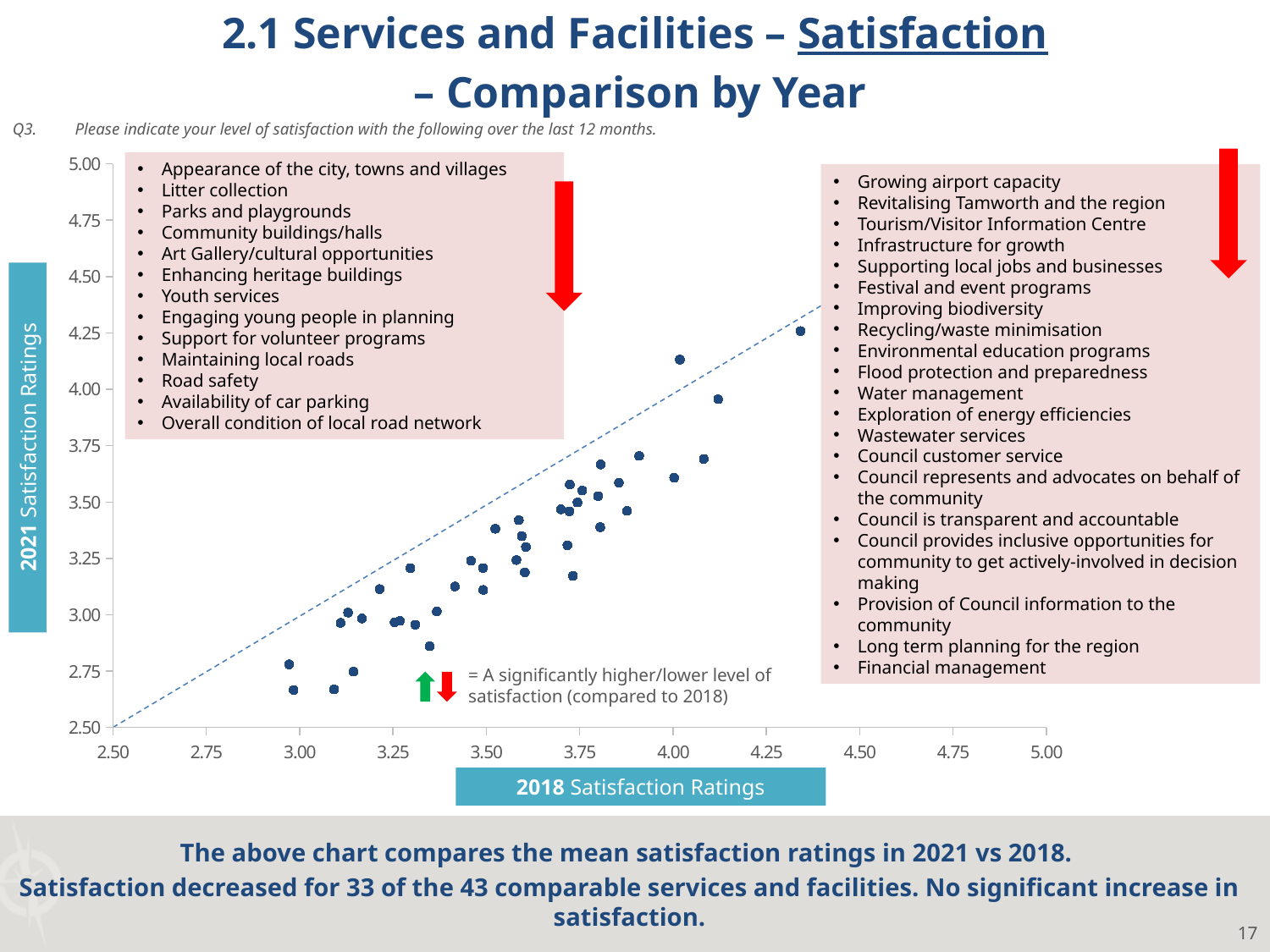
Is the 2018 rating of the rightmost plotted point greater or less than 4.25? greater What is the highest value shown on the x axis of the chart? 5.00 What is the title of the horizontal (x) axis of the chart? 2018 Satisfaction Ratings What is the lowest value shown on the y axis of the chart? 2.50 According to the slide, how many comparable services and facilities are compared in the chart? 43 What is the title of the vertical (y) axis of the chart? 2021 Satisfaction Ratings Is the 2021 rating of the highest plotted point greater or less than 4.00? greater Are most of the plotted points above or below the dashed diagonal line? Below Is the 2021 rating of the lowest plotted point greater or less than 2.75? less According to the slide, for how many of the 43 comparable services and facilities did satisfaction decrease? 33 What kind of chart is shown on the slide? Scatter chart